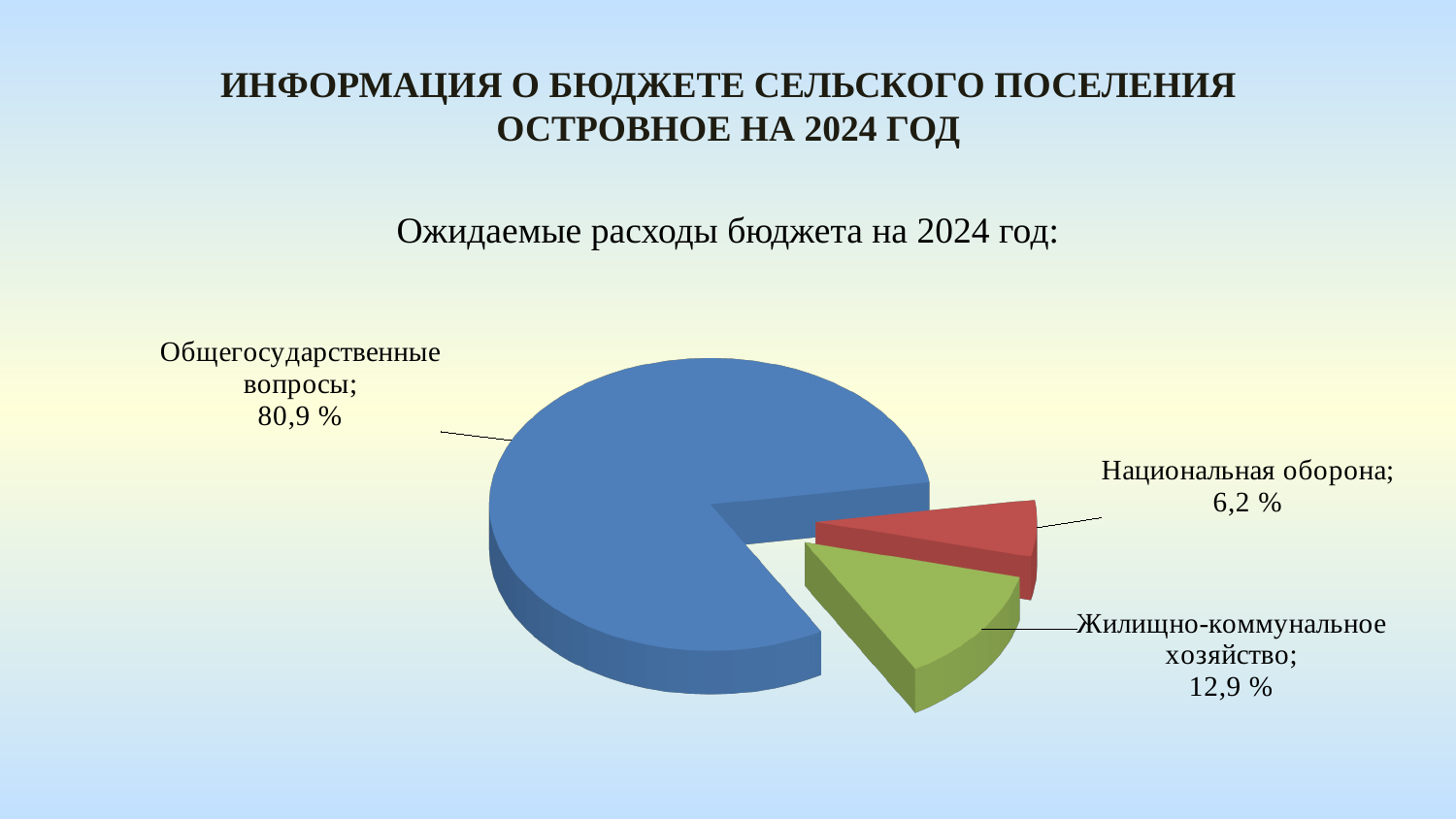
What kind of chart is shown on the slide? Pie chart What share of the pie is labelled for Национальная оборона? 6,2 % What share of the pie is labelled for Общегосударственные вопросы? 80,9 % What is the difference in percentage points between Общегосударственные вопросы and Жилищно-коммунальное хозяйство? 68 What is the subtitle above the chart? Ожидаемые расходы бюджета на 2024 год: What share of the pie is labelled for Жилищно-коммунальное хозяйство? 12,9 % Which category has the largest slice of the pie? Общегосударственные вопросы Which category has the smallest slice of the pie? Национальная оборона How many categories (slices) does the pie chart show? 3 What colour is the slice for Национальная оборона? Red What is the difference in percentage points between Жилищно-коммунальное хозяйство and Национальная оборона? 6,7 Which is larger: the share for Жилищно-коммунальное хозяйство or the share for Национальная оборона? Жилищно-коммунальное хозяйство